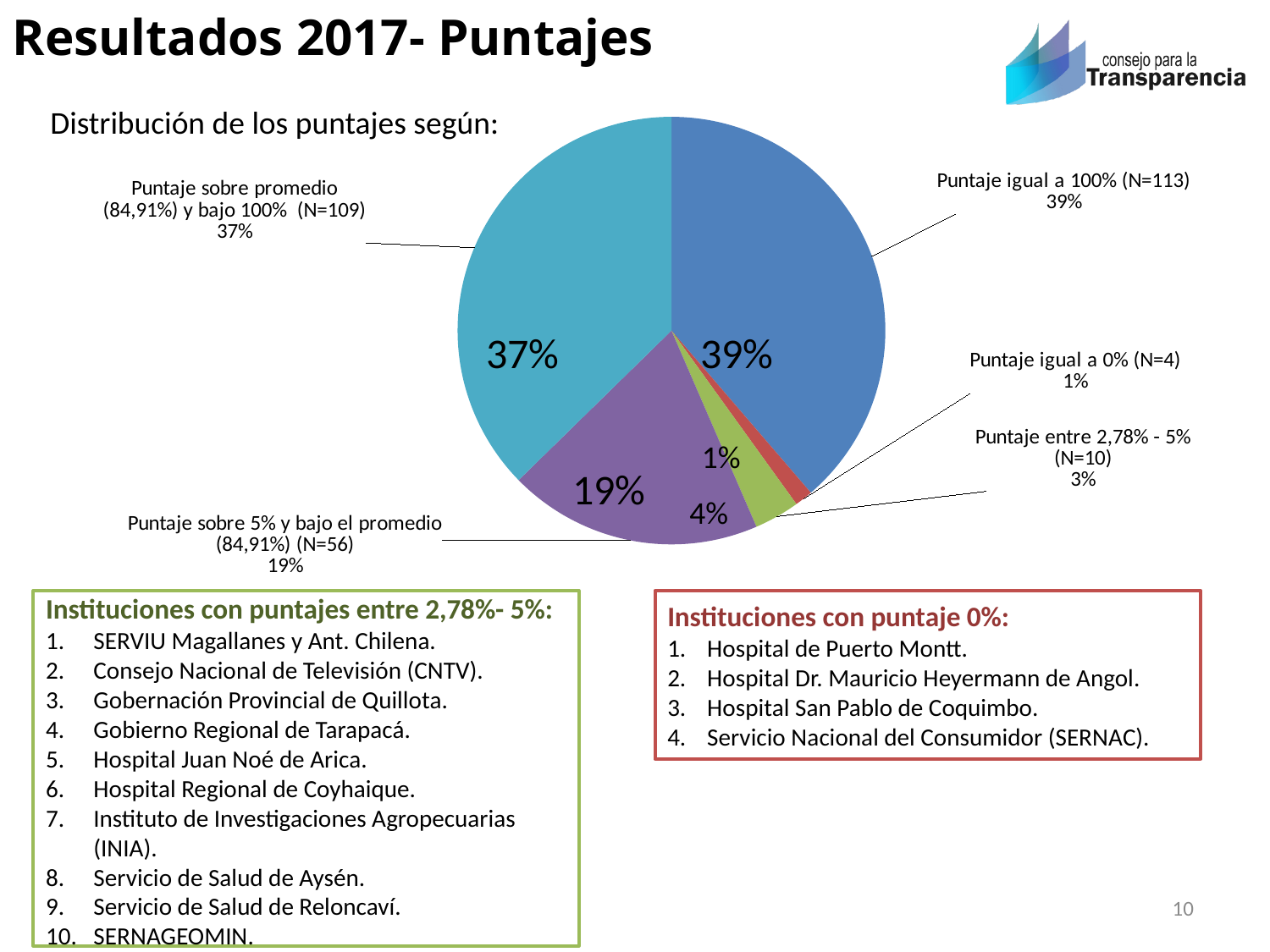
What share of the pie does the 'Puntaje igual a 100%' slice represent? 39% What share of the pie does the 'Puntaje sobre promedio (84,91%) y bajo 100%' slice represent? 37% What is the title of the slide containing the pie chart? Resultados 2017- Puntajes What kind of chart is shown on the slide? pie chart Which category has the smallest slice of the pie? Puntaje igual a 0% (N=4) Which category has the largest slice of the pie? Puntaje igual a 100% (N=113) What share of the pie does the 'Puntaje igual a 0%' slice represent? 1% How many institutions (N) are in the 'Puntaje sobre 5% y bajo el promedio (84,91%)' category? 56 How many institutions (N) are in the 'Puntaje igual a 100%' category? 113 What is the difference in N between the 'Puntaje igual a 100%' category and the 'Puntaje sobre promedio (84,91%) y bajo 100%' category? 4 How many slices does the pie chart have? 5